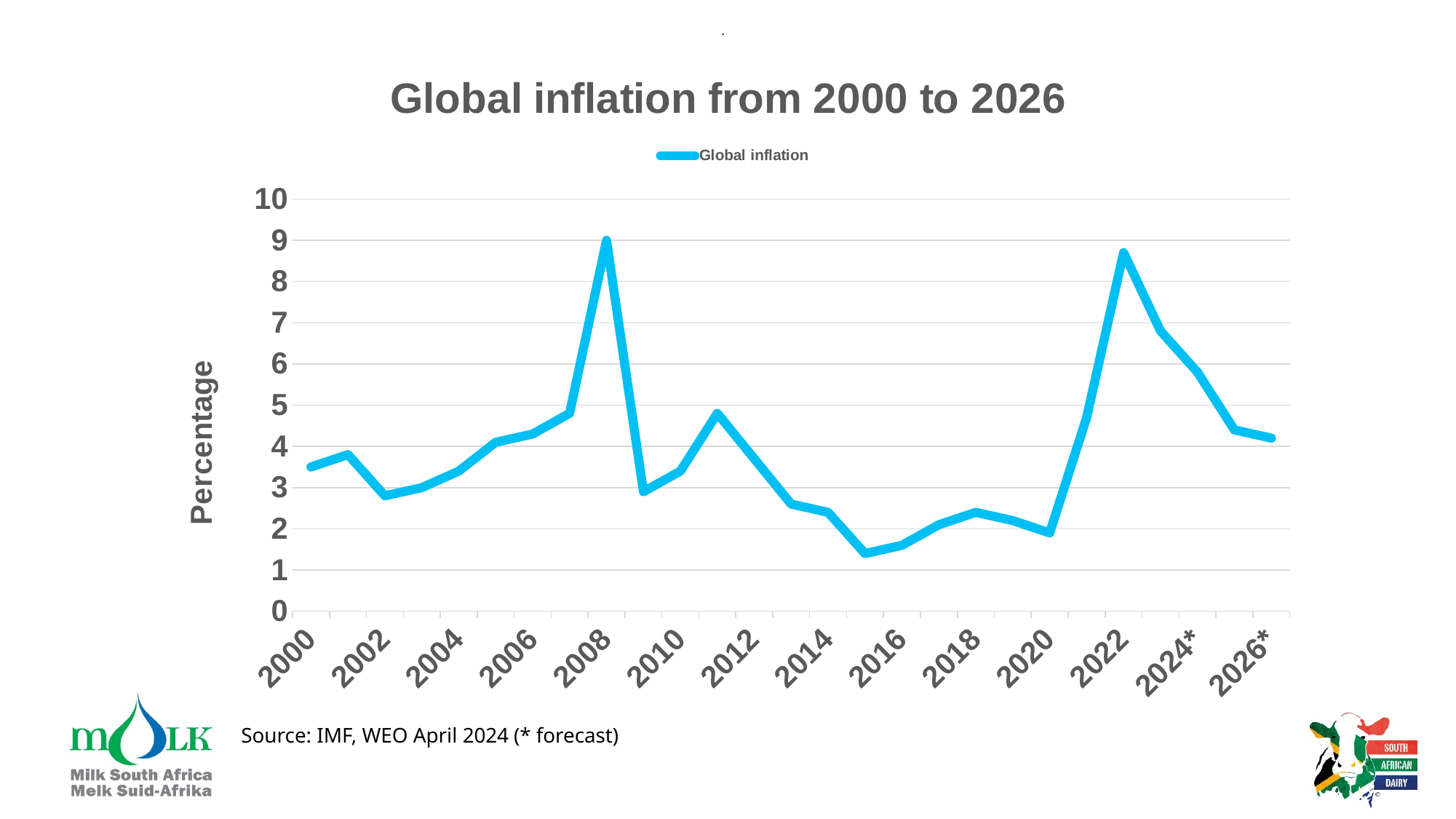
How many series does the legend list? 1 Is the global inflation value for 2015 greater or less than 2? less Is the global inflation value for 2008 greater or less than 8? greater What is the title of the chart? Global inflation from 2000 to 2026 Is the global inflation value for 2018 greater or less than 3? less What is the label on the vertical axis of the chart? Percentage Does global inflation rise or fall from 2022 to 2026*? Fall What kind of chart is shown on the slide? Line chart Which year has the higher global inflation value, 2008 or 2015? 2008 Which year has the lowest global inflation value on the chart? 2015